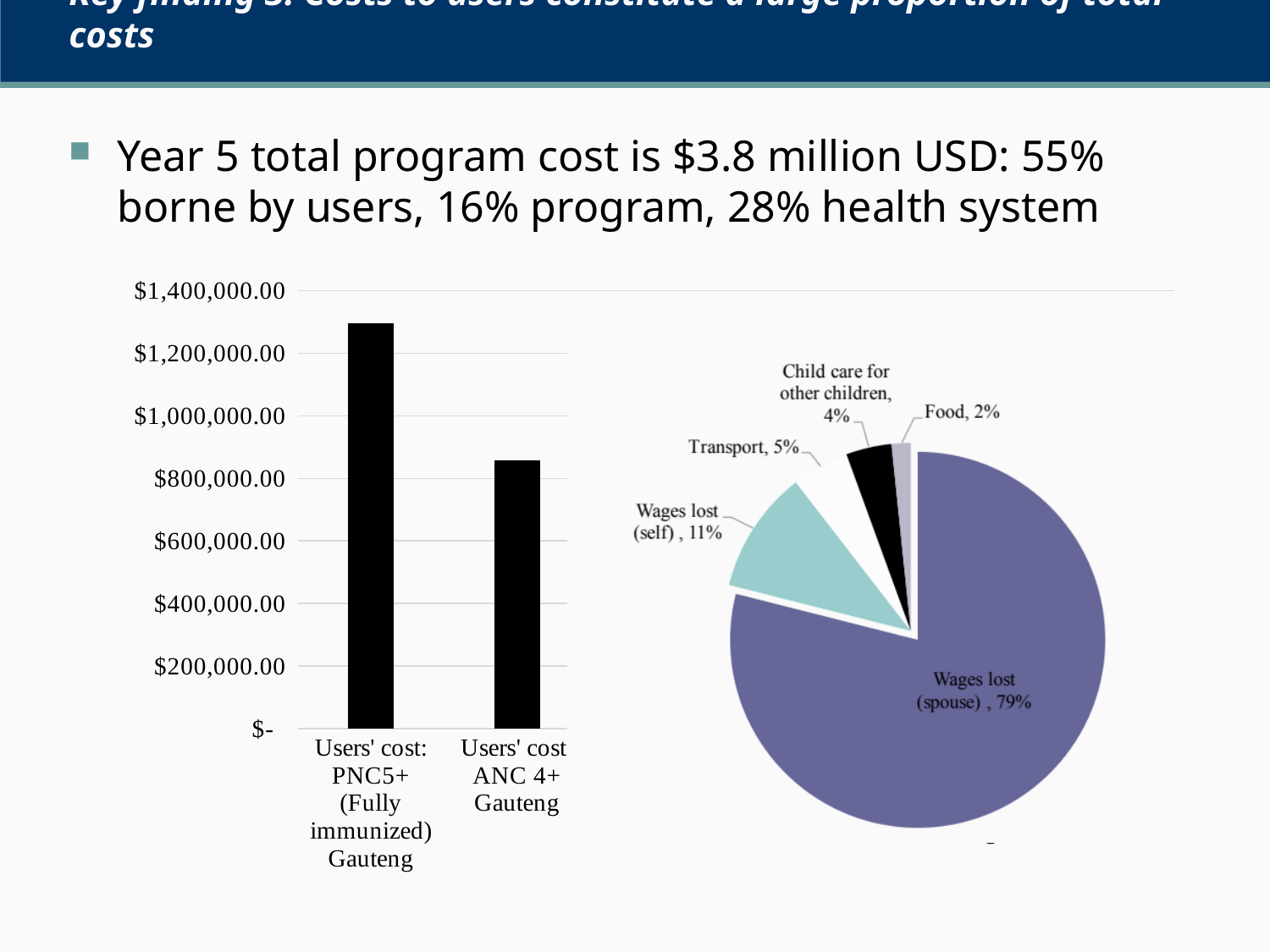
In the bar chart on the left, which category has the higher value? Users' cost: PNC5+ (Fully immunized) Gauteng In the pie chart on the right, which slice is the smallest? Food In the bar chart on the left, is the value for Users' cost: PNC5+ (Fully immunized) Gauteng greater or less than $1,200,000.00? greater In the pie chart on the right, what share is Wages lost (spouse)? 79% In the bar chart on the left, how many bars are plotted? 2 In the bar chart on the left, is the value for Users' cost ANC 4+ Gauteng greater or less than $1,000,000.00? less What kind of chart is the chart on the right side of the slide? pie chart In the bar chart on the left, which category has the lower value? Users' cost ANC 4+ Gauteng What kind of chart is the chart on the left side of the slide? bar chart In the pie chart on the right, what share is Transport? 5% In the bar chart on the left, is the value for Users' cost ANC 4+ Gauteng greater or less than $800,000.00? greater In the pie chart on the right, how many slices are there? 5